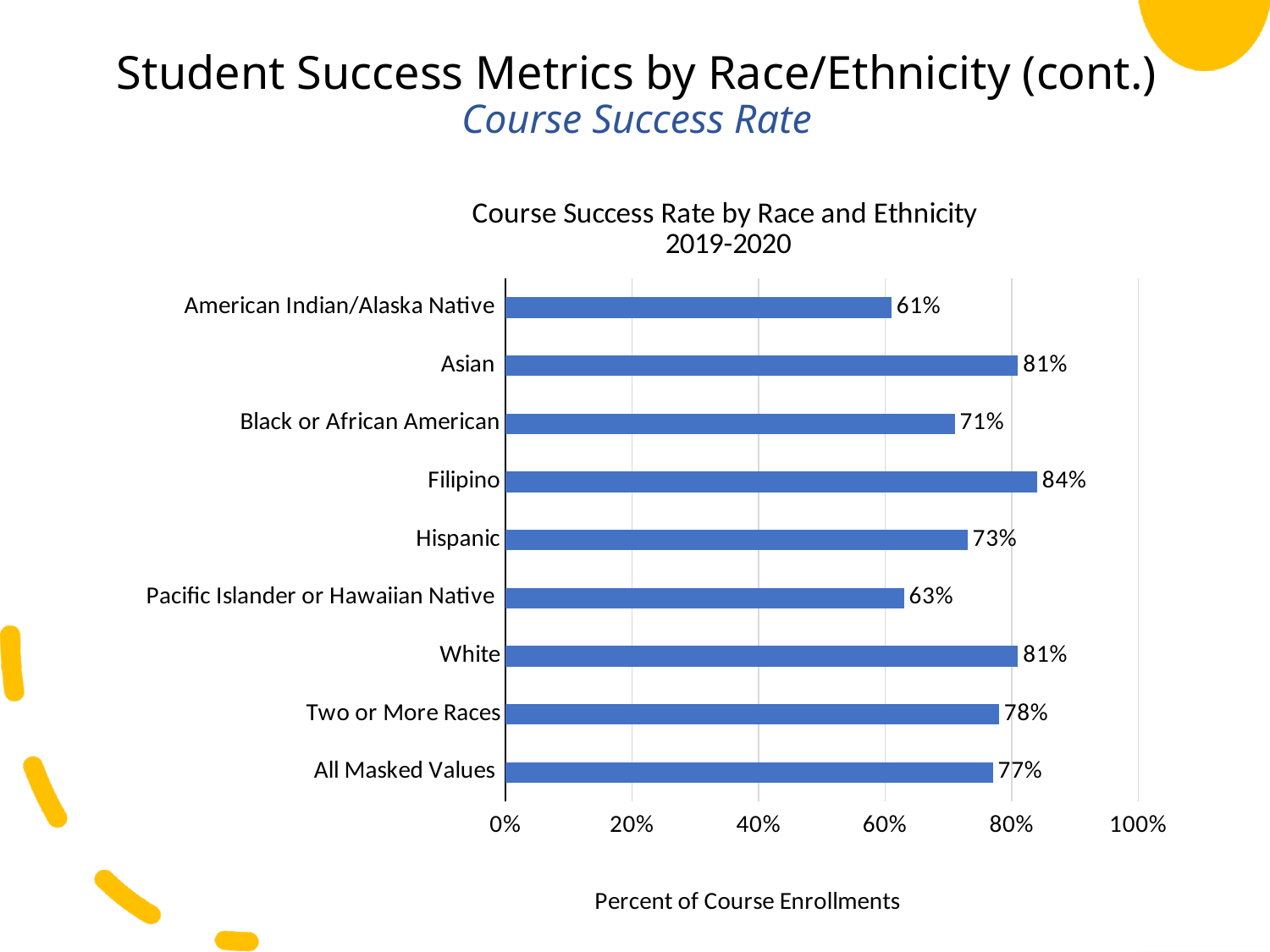
What is the course success rate for Filipino students? 84% What is the course success rate for Two or More Races? 78% Which category has the lowest course success rate? American Indian/Alaska Native How many race/ethnicity categories are shown in the chart? 9 Which category has the highest course success rate? Filipino What is the course success rate for Pacific Islander or Hawaiian Native students? 63% What is the difference between the course success rates for Filipino and American Indian/Alaska Native students? 23% Which has a higher course success rate, Hispanic or Two or More Races? Two or More Races What kind of chart is shown on the slide? Bar chart What is the x-axis label of the chart? Percent of Course Enrollments Is the course success rate for All Masked Values greater or less than 80%? less What is the difference between the course success rates for Hispanic and Black or African American students? 2%